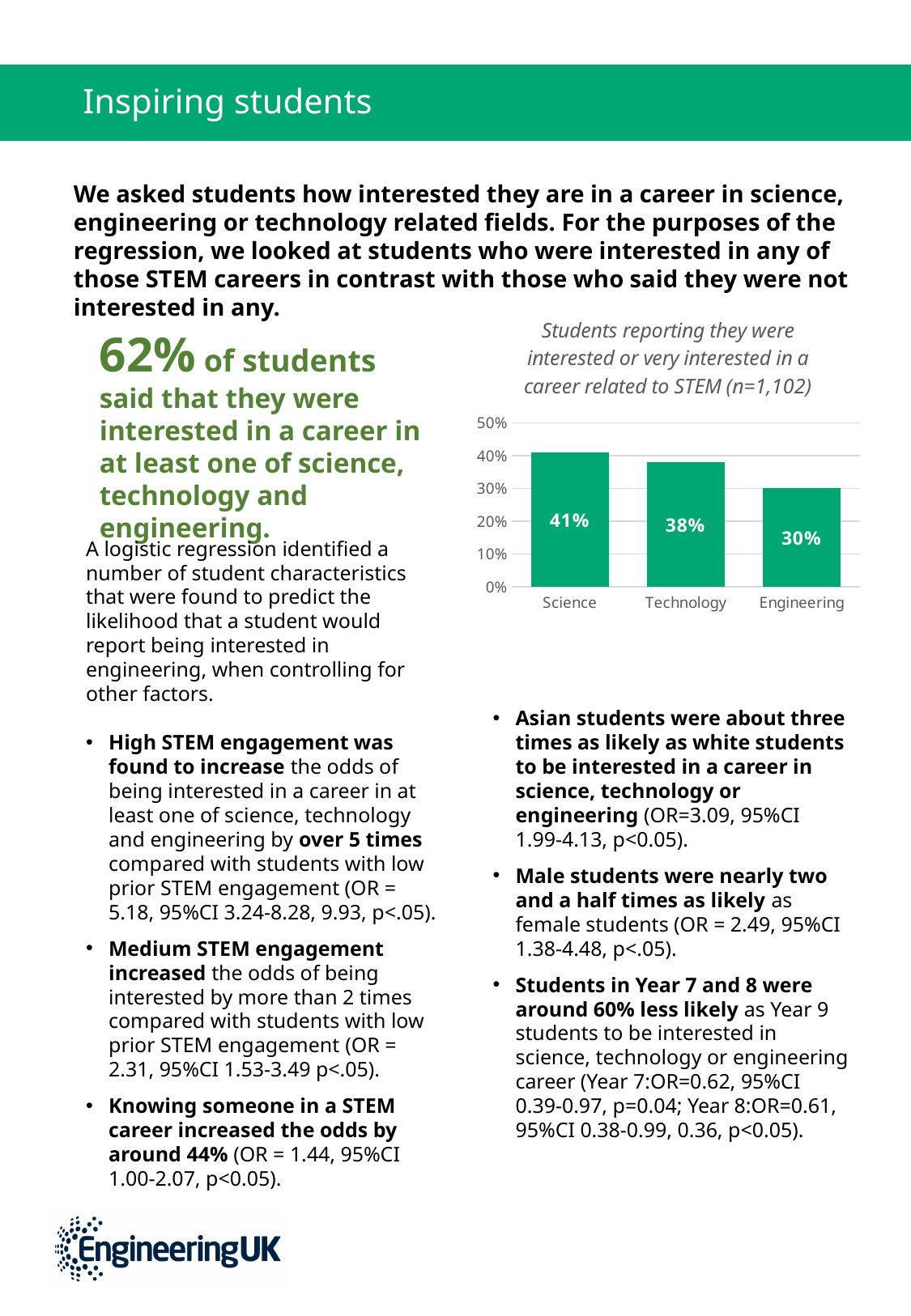
Is the value for Engineering greater or less than 40%? less How many categories are shown in the chart? 3 What is the difference in percentage points between Science and Engineering? 11 What percentage of students reported being interested or very interested in a career related to Science? 41% Which category has the lowest percentage of students interested in a related career? Engineering What percentage of students reported being interested or very interested in a career related to Engineering? 30% Which category has the highest percentage of students interested in a related career? Science What type of chart is shown on the slide? bar chart What percentage of students reported being interested or very interested in a career related to Technology? 38% Which has a higher value, Technology or Engineering? Technology What is the sample size (n) stated in the chart title? 1,102 What is the difference in percentage points between Science and Technology? 3